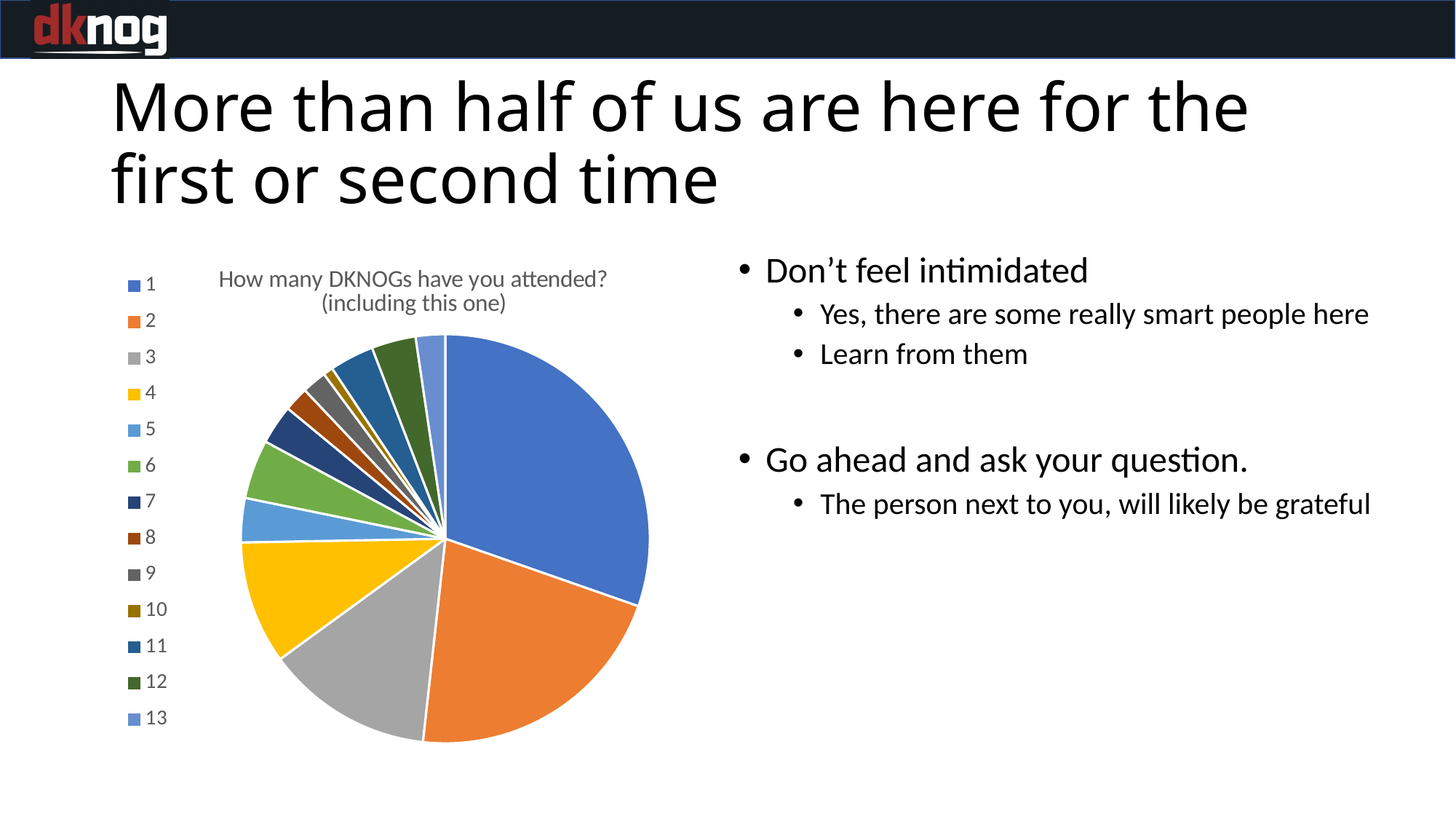
What kind of chart is shown on the slide? pie chart Which slice is larger in the pie chart, category 5 or category 6? 6 Which category has the smallest slice of the pie chart? 10 What is the title of the pie chart? How many DKNOGs have you attended? (including this one) Which slice is larger in the pie chart, category 1 or category 2? 1 How many categories does the legend of the pie chart list? 13 What colour is the slice for category 4 in the pie chart? yellow Which slice is larger in the pie chart, category 4 or category 7? 4 Which category has the largest slice of the pie chart? 1